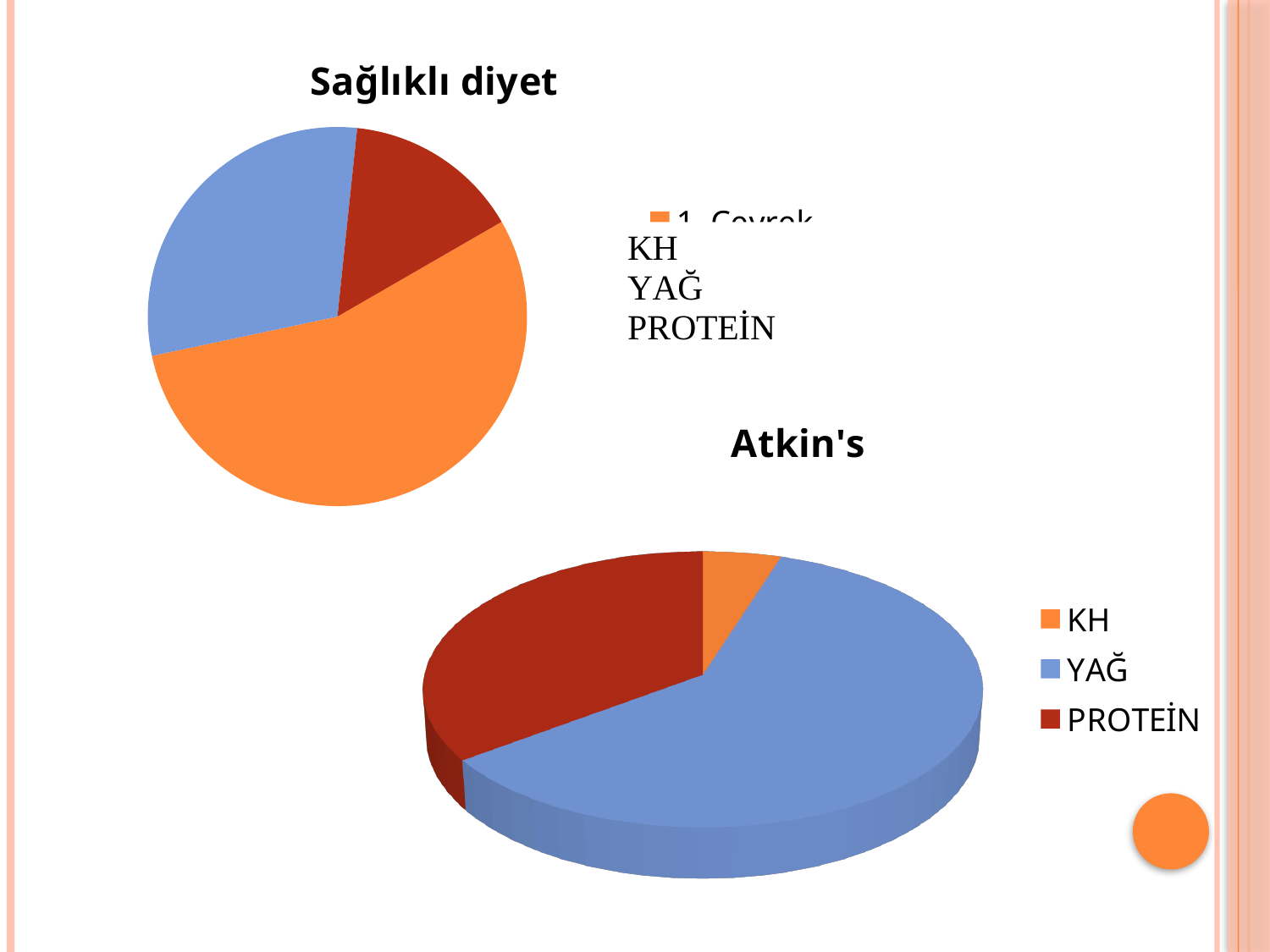
In the "Atkin's" chart, which category has the smallest slice? KH In the "Atkin's" chart, how many entries does the legend list? 3 What kind of chart is the "Atkin's" chart? Pie chart In the "Atkin's" chart, which category has the largest slice? YAĞ What kind of chart is the "Sağlıklı diyet" chart? Pie chart In the "Sağlıklı diyet" chart, how many slices does the pie have? 3 In the "Atkin's" chart, which slice is larger, PROTEİN or KH? PROTEİN What is the title of the lower chart on the slide? Atkin's In the "Sağlıklı diyet" chart, which colour slice is the smallest? Red In the "Atkin's" chart, how many slices does the pie have? 3 In the "Sağlıklı diyet" chart, which colour slice is the largest? Orange In the "Sağlıklı diyet" chart, which slice is larger, the blue one or the red one? Blue